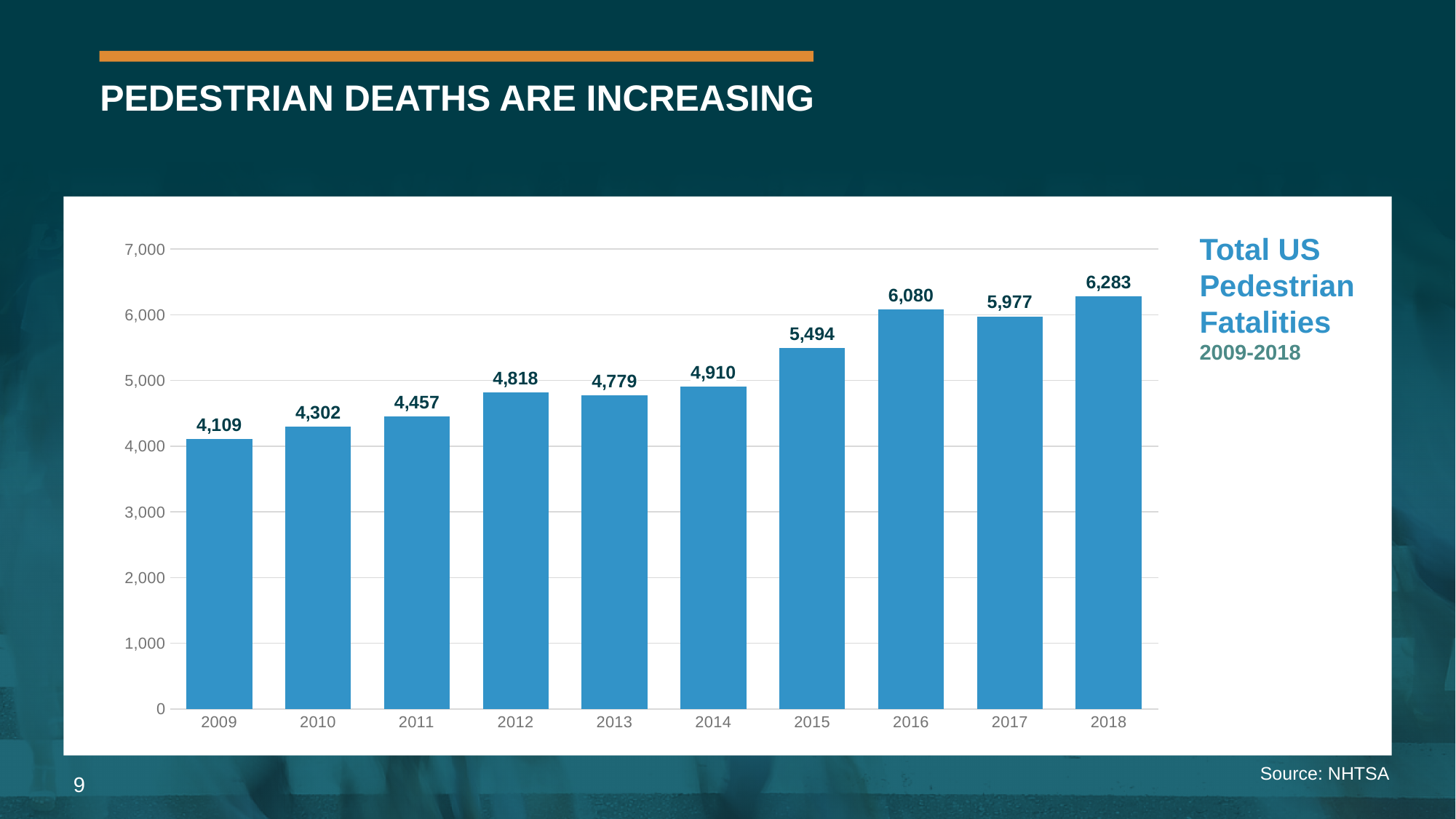
Which is larger, the value for 2012 or the value for 2013? 2012 How many years are shown on the x axis? 10 Do the values generally rise or fall from 2009 to 2018? rise What is the value for 2017? 5,977 What is the value for 2015? 5,494 Is the value for 2014 greater or less than 5,000? less Which year has the lowest value? 2009 What kind of chart is shown on the slide? bar chart What is the difference between the values for 2016 and 2017? 103 Which year has the highest value? 2018 What is the value for 2009? 4,109 What is the difference between the values for 2018 and 2009? 2,174